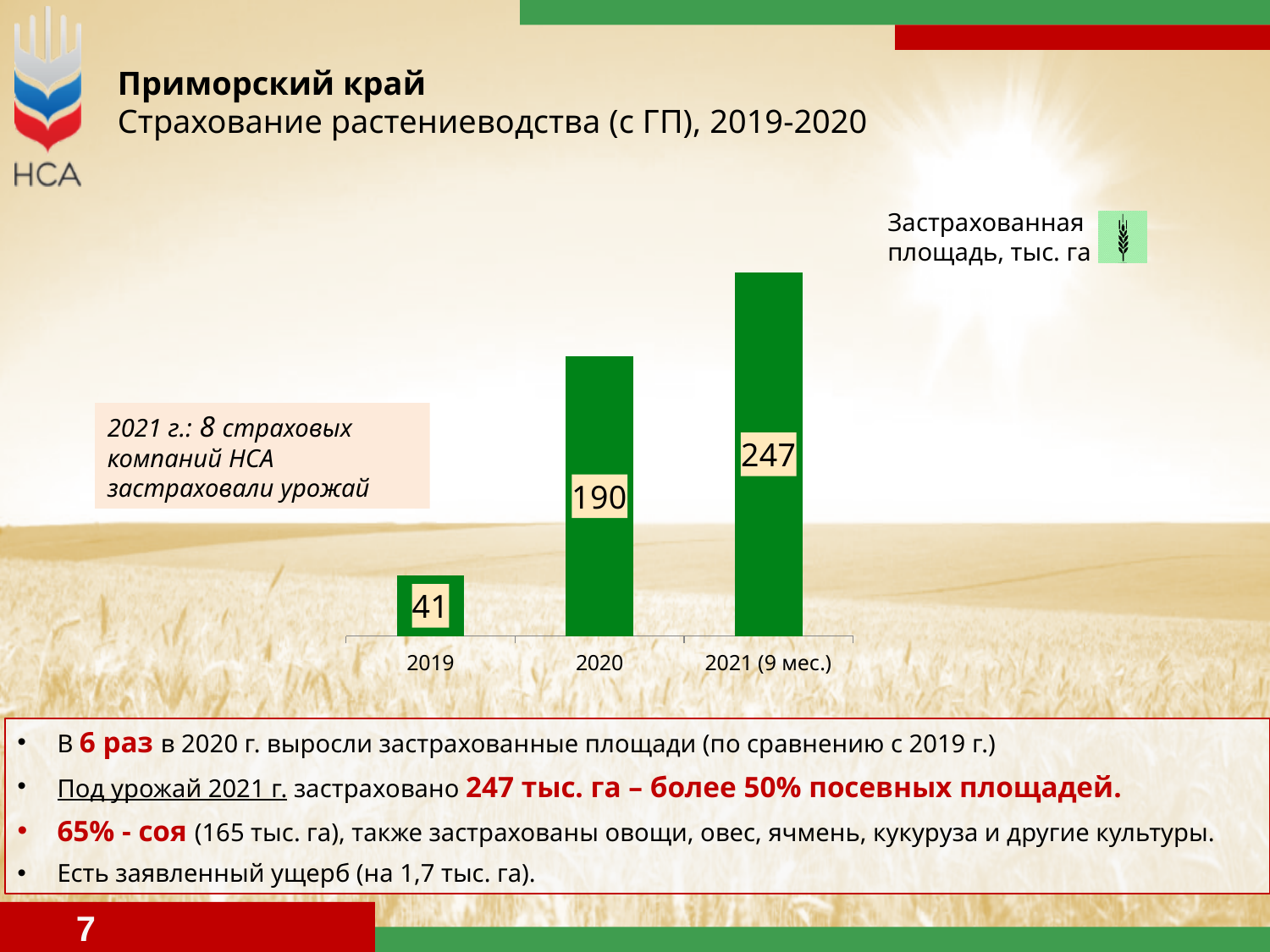
What is the difference between the insured area in 2021 (9 мес.) and in 2020? 57 What unit is the insured area measured in, according to the chart legend? тыс. га What is the insured area value for 2019? 41 Which category has the highest insured area? 2021 (9 мес.) Which is larger, the insured area in 2020 or in 2019? 2020 Do the values rise or fall from 2019 to 2021 (9 мес.)? rise What is the difference between the insured area in 2020 and in 2019? 149 What kind of chart is shown on the slide? bar chart Which category has the lowest insured area? 2019 What is the insured area value for 2021 (9 мес.)? 247 What is the insured area value for 2020? 190 How many categories are shown on the x axis of the chart? 3